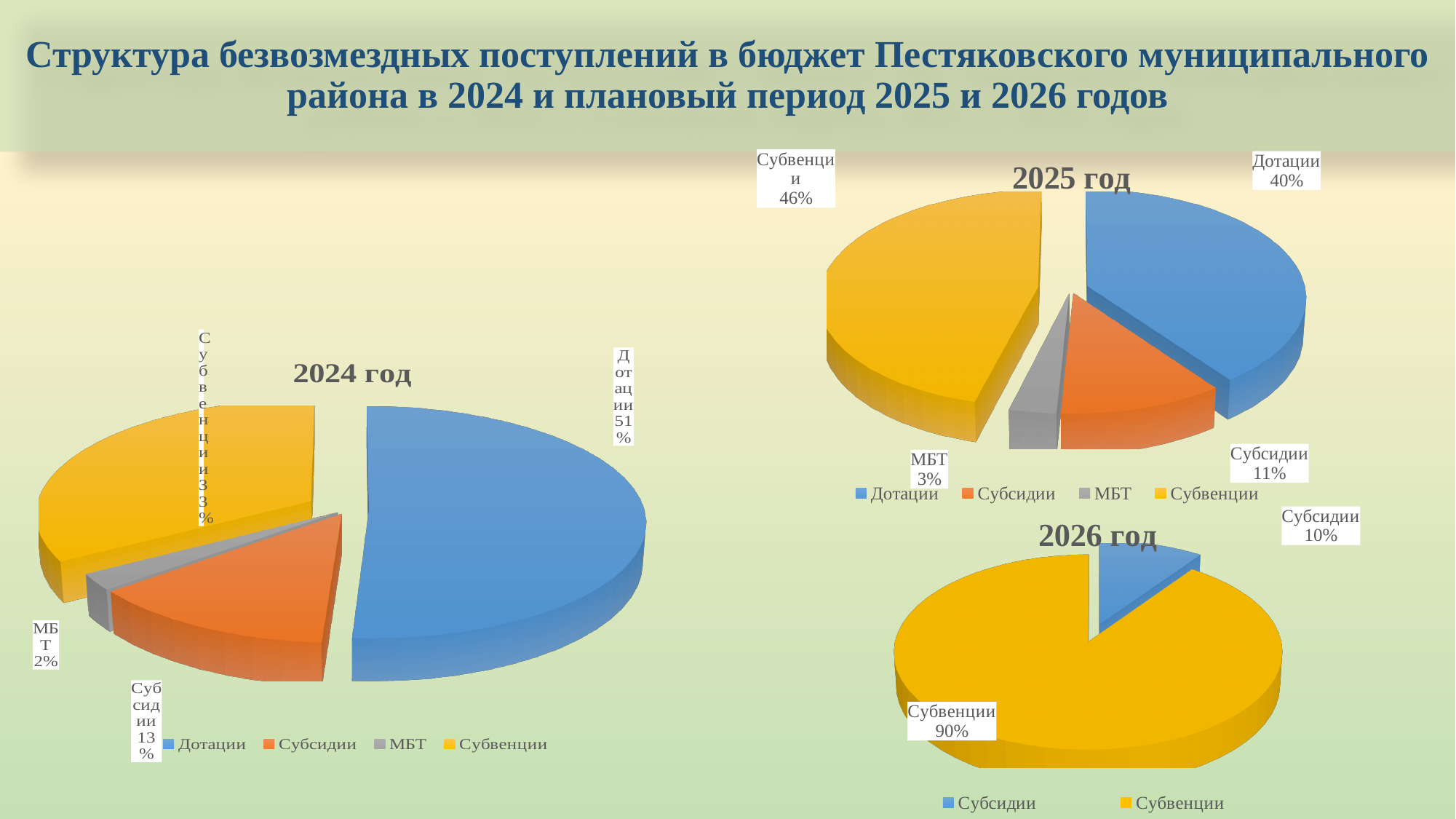
In the "2024 год" pie chart, which category has the smallest share? МБТ In the "2025 год" pie chart, which is larger: Субсидии or МБТ? Субсидии In the "2026 год" pie chart, what share is shown for Субвенции? 90% How many slices does the "2024 год" pie chart have? 4 In the "2024 год" pie chart, what share is shown for Субсидии? 13% In the "2025 год" pie chart, what share is shown for Субвенции? 46% In the "2025 год" pie chart, what is the difference between the shares of Дотации and Субсидии? 29% In the "2024 год" pie chart, what colour is the Субвенции slice? Yellow In the "2024 год" pie chart, what share is shown for Дотации? 51% In the "2025 год" pie chart, which category has the largest share? Субвенции What type of chart is used for "2025 год"? Pie chart How many categories does the legend of the "2026 год" pie chart list? 2